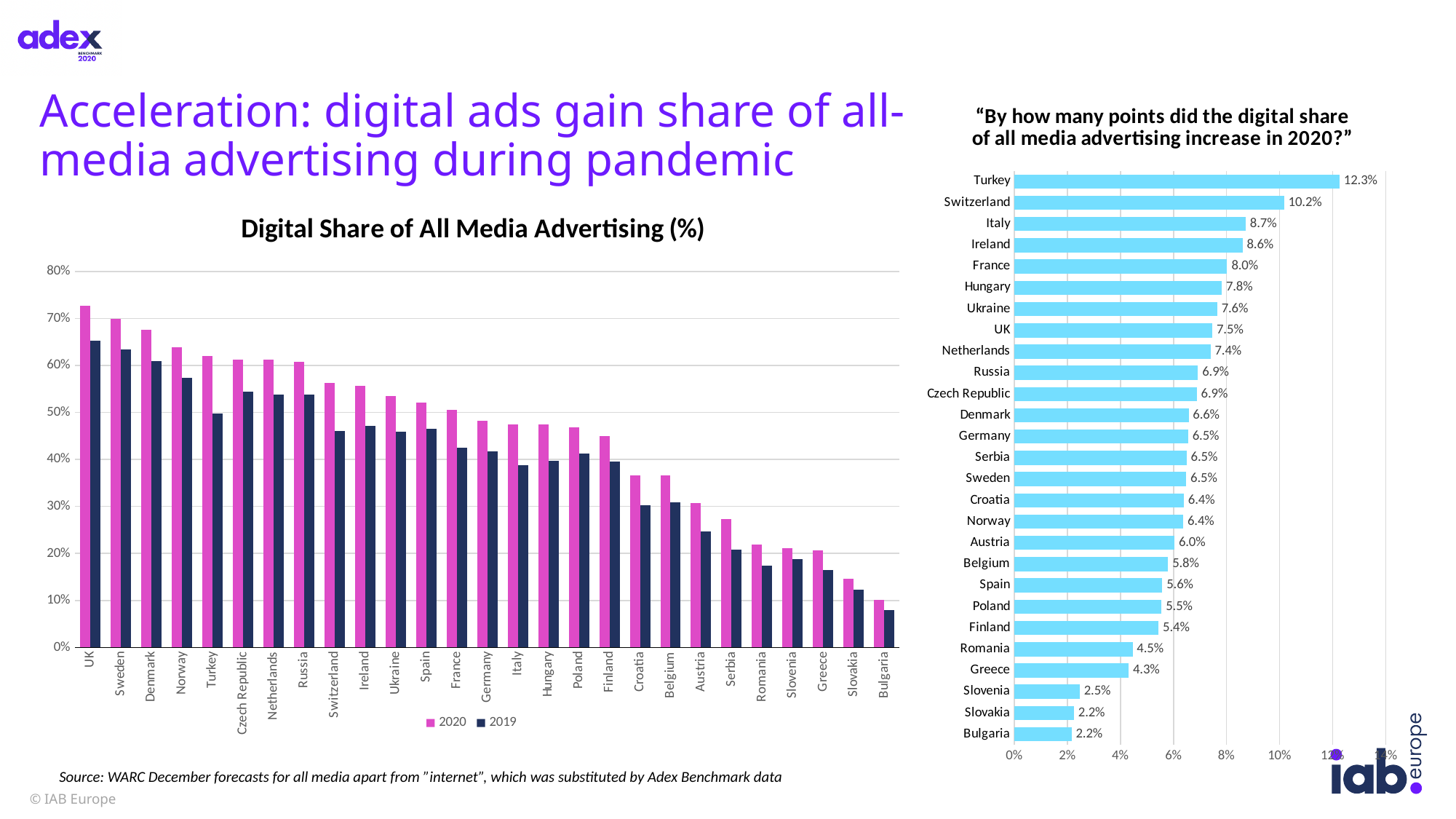
In the chart titled "By how many points did the digital share of all media advertising increase in 2020?", what is the value for Hungary? 7.8% What kind of chart is the "Digital Share of All Media Advertising (%)" chart? Bar chart In the "Digital Share of All Media Advertising (%)" chart, is the 2020 value for the UK greater or less than 70%? greater In the chart titled "By how many points did the digital share of all media advertising increase in 2020?", what is the value for Greece? 4.3% In the "Digital Share of All Media Advertising (%)" chart, is the 2019 value for Bulgaria greater or less than 10%? less In the chart titled "By how many points did the digital share of all media advertising increase in 2020?", how many countries are shown? 27 In the chart titled "By how many points did the digital share of all media advertising increase in 2020?", which country has the highest value? Turkey In the chart titled "By how many points did the digital share of all media advertising increase in 2020?", what is the value for Turkey? 12.3% In the chart titled "By how many points did the digital share of all media advertising increase in 2020?", what is the difference between the values for Switzerland and Italy? 1.5% How many series does the legend of the "Digital Share of All Media Advertising (%)" chart list? 2 In the chart titled "By how many points did the digital share of all media advertising increase in 2020?", which is larger, the value for France or the value for Ukraine? France In the "Digital Share of All Media Advertising (%)" chart, do the 2020 values rise or fall moving from left to right along the x axis? fall